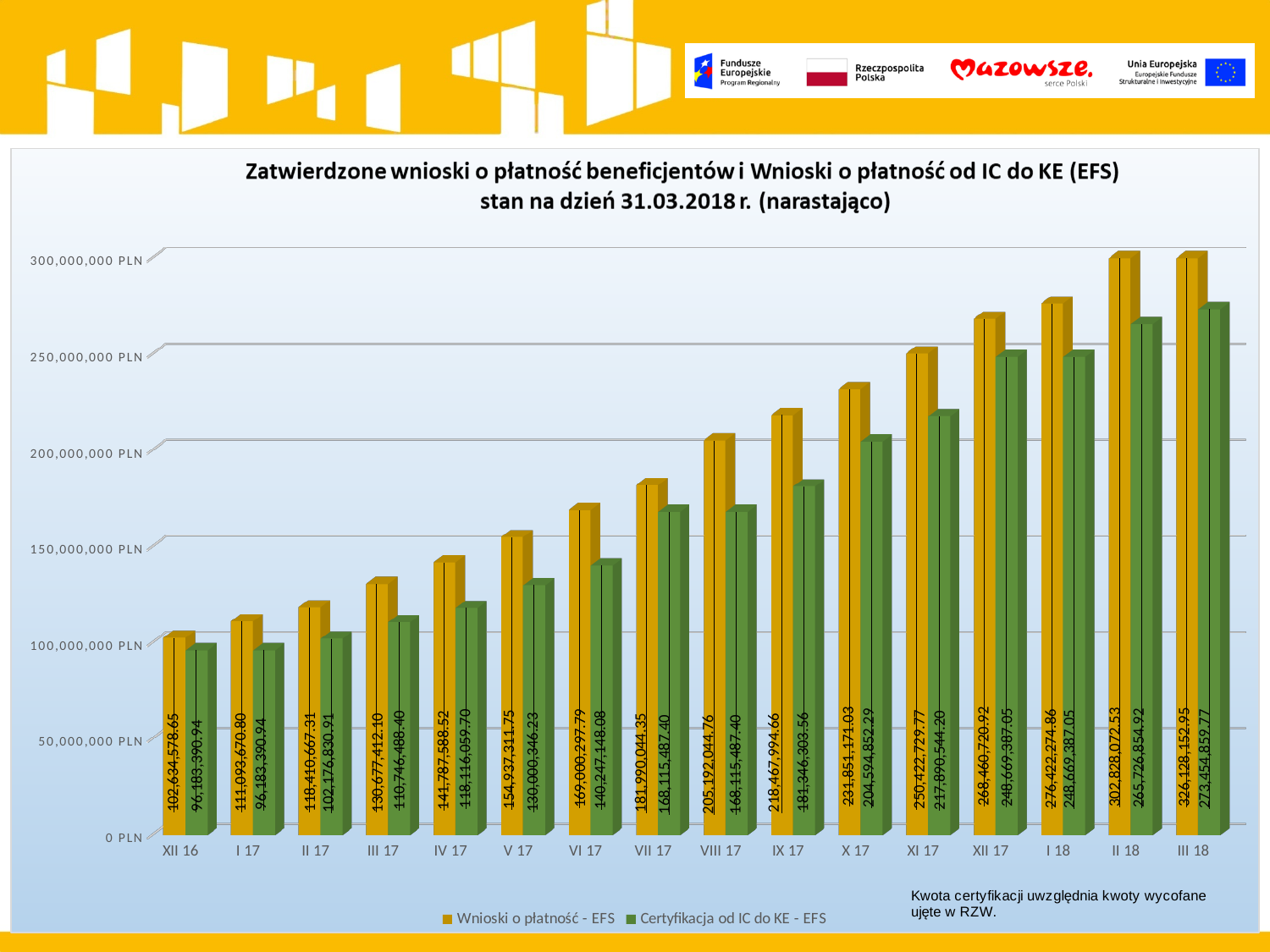
What is the value of 'Wnioski o płatność - EFS' for III 18? 326,128,152.95 What is the value of 'Certyfikacja od IC do KE - EFS' for XII 17? 248,669,387.05 How many periods (categories) are shown on the x axis? 16 For VIII 17, which is larger: 'Wnioski o płatność - EFS' or 'Certyfikacja od IC do KE - EFS'? Wnioski o płatność - EFS What is the difference between 'Wnioski o płatność - EFS' and 'Certyfikacja od IC do KE - EFS' for III 18? 52,673,293.18 Which period has the lowest value for 'Wnioski o płatność - EFS'? XII 16 How many series does the legend list? 2 What type of chart is shown on the slide? Bar chart Do the values of 'Wnioski o płatność - EFS' rise or fall from XII 16 to III 18? Rise Which period has the highest value for 'Wnioski o płatność - EFS'? III 18 Is the value of 'Certyfikacja od IC do KE - EFS' for VI 17 greater or less than 150,000,000 PLN? less What is the value of 'Wnioski o płatność - EFS' for V 17? 154,937,311.75